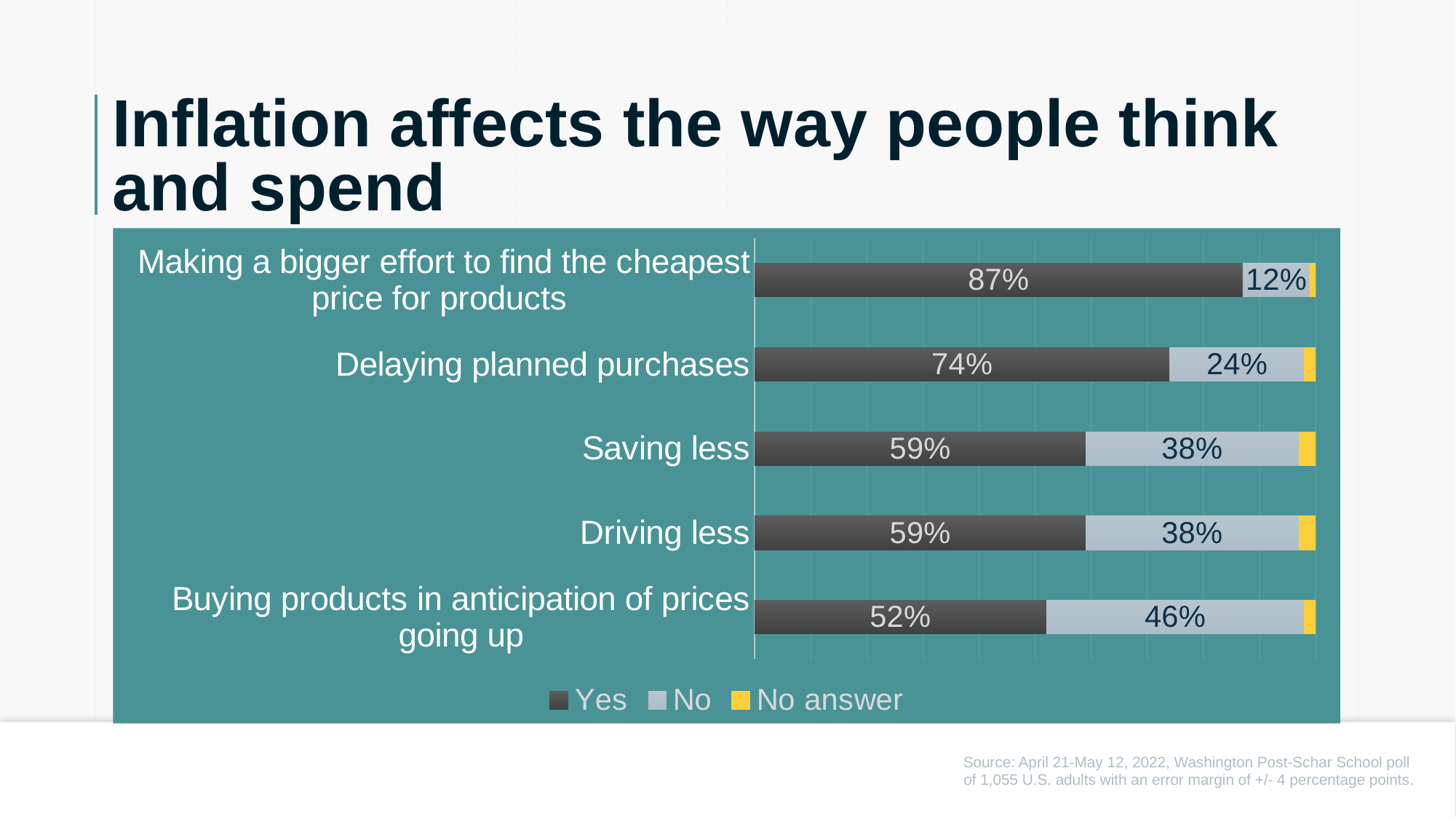
What is the No value for saving less? 38% Which series is shown in yellow in the legend? No answer How many categories are shown in the chart? 5 What is the Yes value for buying products in anticipation of prices going up? 52% What is the difference between the Yes percentages for delaying planned purchases and saving less? 15% Which is larger: the No percentage for driving less or the No percentage for delaying planned purchases? Driving less What percentage of respondents said Yes to making a bigger effort to find the cheapest price for products? 87% How many series does the legend list? 3 What kind of chart is shown on the slide? Stacked bar chart Which category has the highest Yes percentage? Making a bigger effort to find the cheapest price for products What percentage of respondents said No to delaying planned purchases? 24% Which category has the lowest Yes percentage? Buying products in anticipation of prices going up